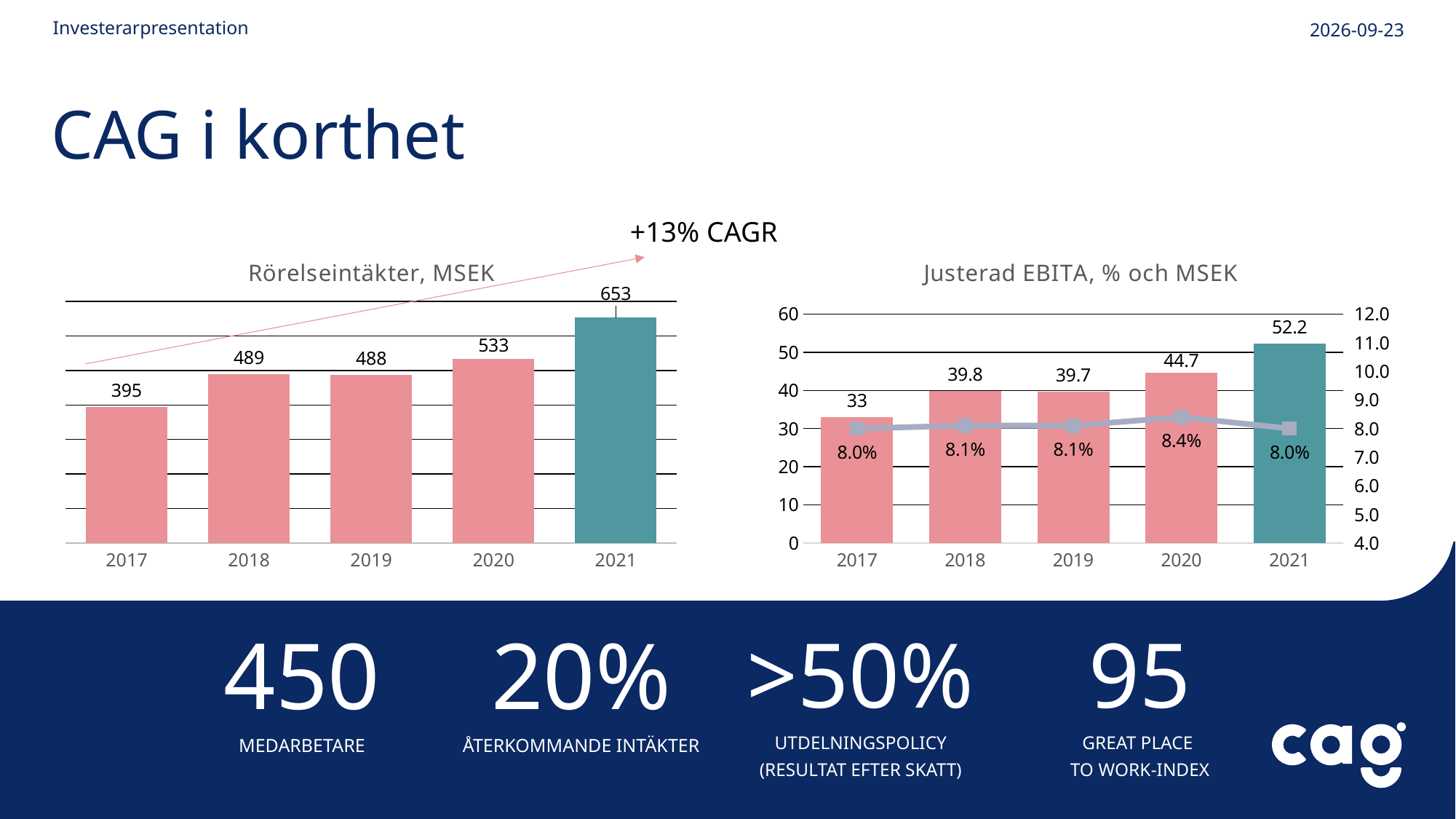
What CAGR is annotated above the 'Rörelseintäkter, MSEK' chart? +13% CAGR In the 'Justerad EBITA, % och MSEK' chart, is the bar value for 2019 larger or smaller than the bar value for 2018? Smaller In the 'Rörelseintäkter, MSEK' chart, which year has the lowest value? 2017 In the 'Justerad EBITA, % och MSEK' chart, what is the MSEK bar value for 2020? 44.7 In the 'Rörelseintäkter, MSEK' chart, what is the difference between the 2021 and 2020 values? 120 In the 'Rörelseintäkter, MSEK' chart, what is the value for 2021? 653 In the 'Justerad EBITA, % och MSEK' chart, which year has the highest bar value? 2021 In the 'Justerad EBITA, % och MSEK' chart, what is the difference between the bar values for 2021 and 2017? 19.2 In the 'Rörelseintäkter, MSEK' chart, how many years are shown on the x axis? 5 In the 'Justerad EBITA, % och MSEK' chart, what is the percentage value for 2020? 8.4% In the 'Justerad EBITA, % och MSEK' chart, is the bar value for 2017 greater or less than 40? less What type of chart is the 'Rörelseintäkter, MSEK' chart? Bar chart